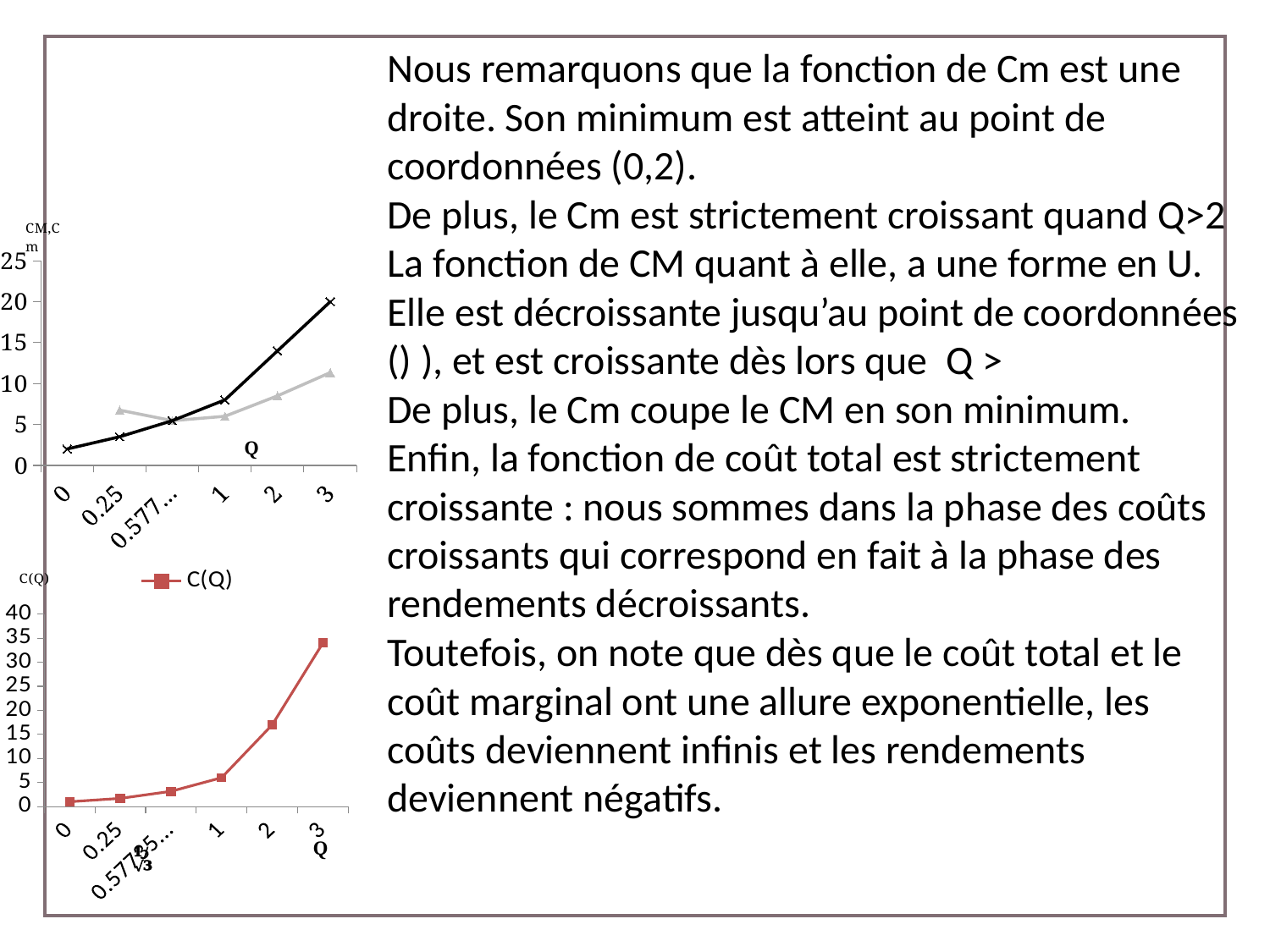
In the bottom chart (C(Q)), is the value at Q = 3 greater or less than 30? greater What kind of chart is the top chart (CM, Cm)? line chart In the bottom chart (C(Q)), is the value at Q = 2 greater or less than 20? less In the bottom chart (C(Q)), do the values rise or fall as Q increases? rise In the top chart (CM, Cm), is the value of the black line at Q = 2 greater or less than 10? greater In the top chart (CM, Cm), at Q = 0.25, which line is higher: the black line or the gray line? the gray line What is the legend entry shown in the bottom chart? C(Q) What kind of chart is the bottom chart (C(Q))? line chart In the bottom chart (C(Q)), at which Q value is C(Q) highest? 3 In the bottom chart (C(Q)), how many data points are plotted? 6 In the bottom chart (C(Q)), how many series does the legend list? 1 In the top chart (CM, Cm), at Q = 3, which line is higher: the black line or the gray line? the black line